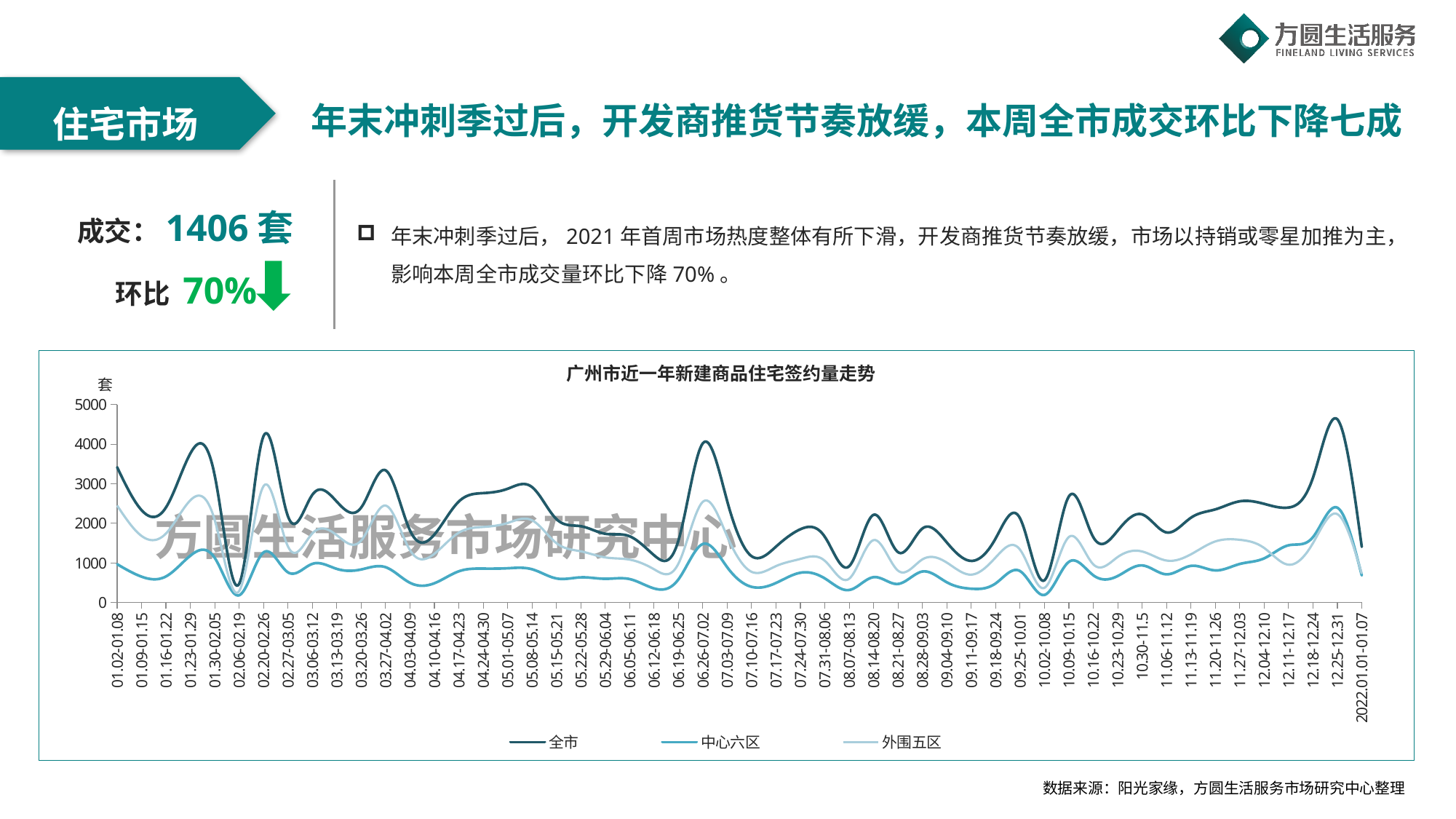
In which week does the 全市 series reach its highest value? 12.25-12.31 What are the three series named in the chart legend? 全市, 中心六区, 外围五区 How many series does the chart legend list? 3 What kind of chart is shown on the slide? line chart Is the 全市 value for 06.26-07.02 greater or less than 3000? greater Is the 全市 value for 12.25-12.31 greater or less than 4000? greater For the week 02.20-02.26, which series has the larger value, 中心六区 or 外围五区? 外围五区 Does the 全市 series rise or fall from 12.25-12.31 to 2022.01.01-01.07? fall What is the title of the chart? 广州市近一年新建商品住宅签约量走势 Is the 外围五区 value for 02.20-02.26 greater or less than 2000? greater